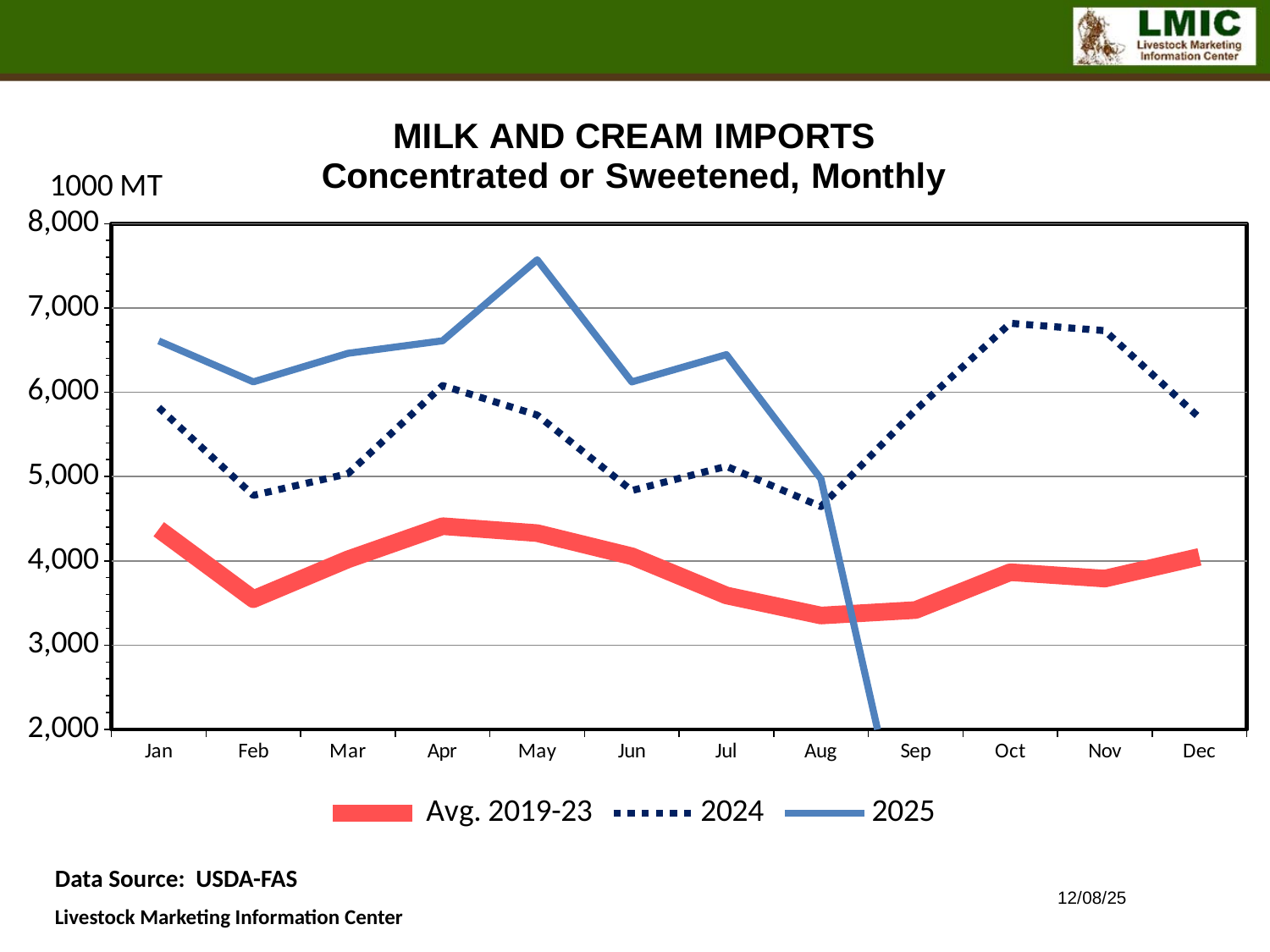
What kind of chart is shown on the slide? line chart Is the Avg. 2019-23 value for Aug greater or less than 4,000? less Is the 2024 value for Feb greater or less than 5,000? less Is the 2025 value for May greater or less than 7,000? greater In Jan, which series has the larger value, Avg. 2019-23 or 2024? 2024 In May, which series has the larger value, 2024 or 2025? 2025 How many months are shown along the x axis? 12 Does the 2025 series rise or fall from May to Aug? fall How many series does the legend list? 3 What unit is shown on the y axis of the chart? 1000 MT In which month does the 2025 series reach its highest value? May